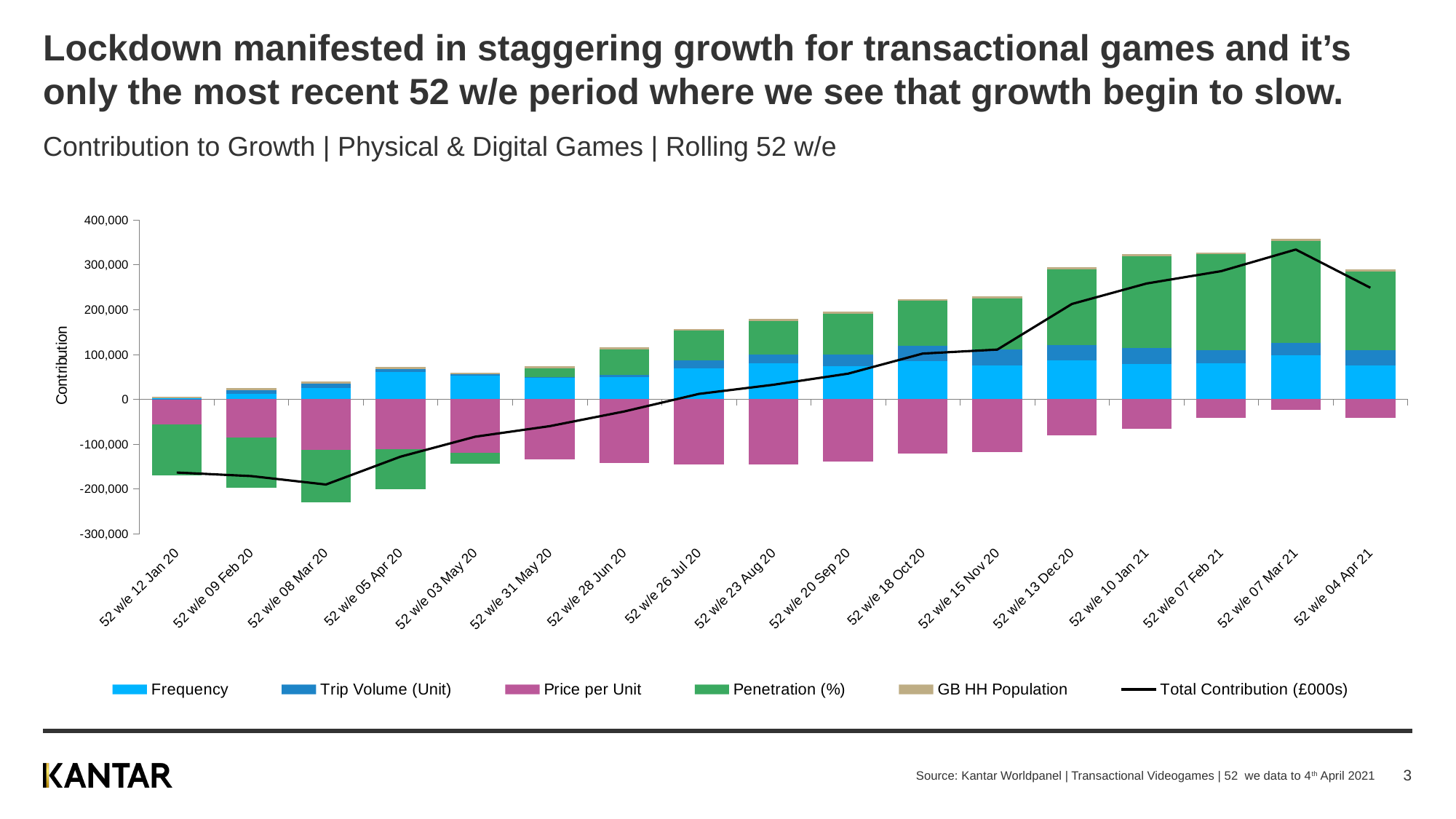
Which period has the larger Total Contribution (£000s): 52 w/e 07 Mar 21 or 52 w/e 04 Apr 21? 52 w/e 07 Mar 21 Is the Total Contribution (£000s) value for 52 w/e 04 Apr 21 greater or less than 200,000? greater In which period does the Total Contribution (£000s) line reach its lowest point? 52 w/e 08 Mar 20 Which legend entry is shown as a black line rather than a bar segment? Total Contribution (£000s) In which period does the Total Contribution (£000s) line reach its highest point? 52 w/e 07 Mar 21 What kind of chart is shown on the slide? A stacked bar chart with a line overlay Is the Total Contribution (£000s) value for 52 w/e 12 Jan 20 greater or less than -100,000? less How many series does the legend list? 6 What is the label on the vertical axis of the chart? Contribution Does the Total Contribution (£000s) line generally rise or fall from 52 w/e 08 Mar 20 to 52 w/e 07 Mar 21? Rise How many rolling 52 w/e periods are plotted along the x axis? 17 Is the Total Contribution (£000s) value for 52 w/e 07 Mar 21 greater or less than 300,000? greater